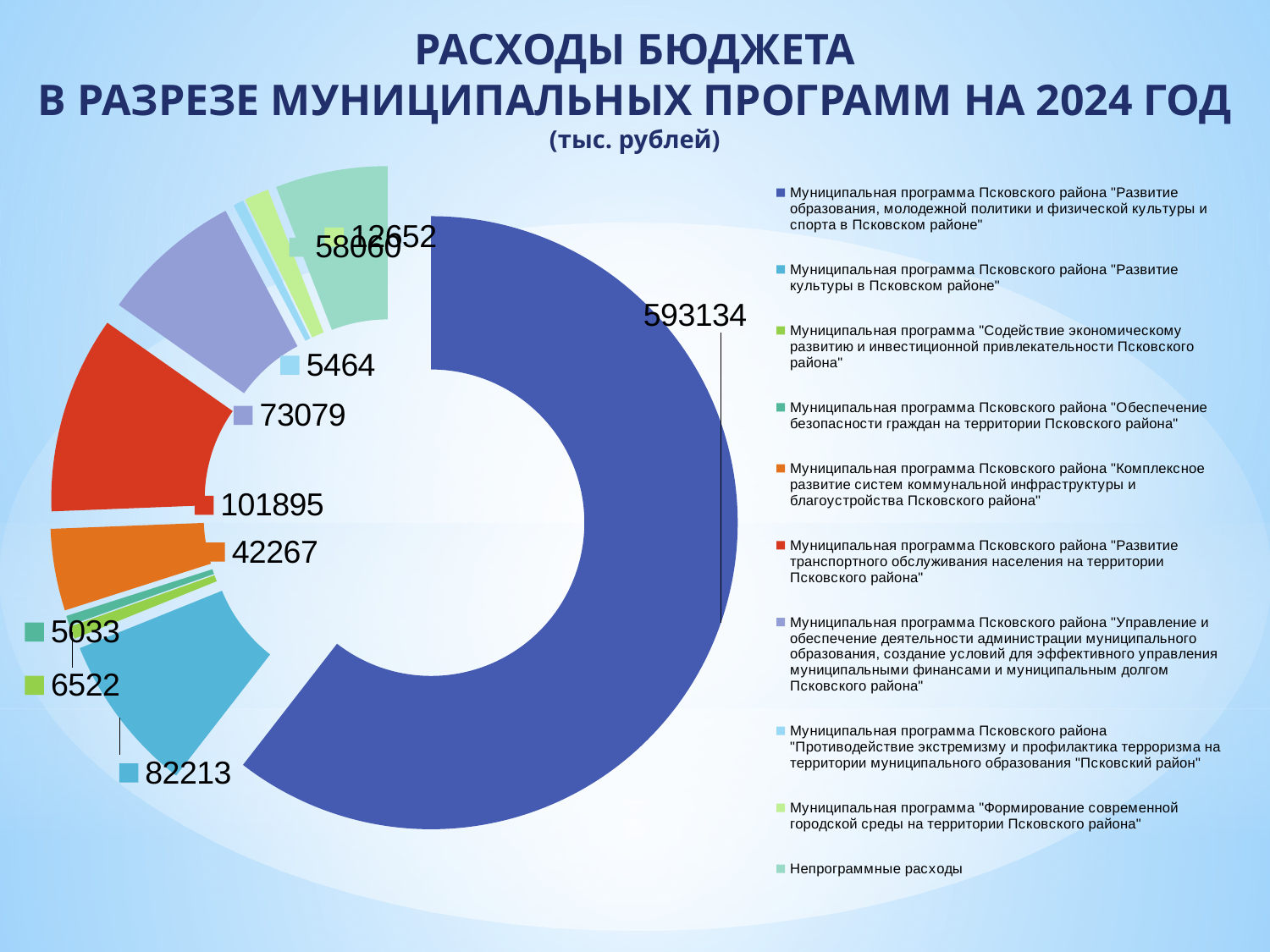
What is the difference between the transport services program (101895) and the culture program (82213)? 19682 Which is larger: the value for the transport services program or the value for the culture program? Transport services program (101895) How many entries does the legend list? 10 What kind of chart is shown on the slide? Doughnut (pie) chart What is the value for the municipal program "Управление и обеспечение деятельности администрации муниципального образования..."? 73079 What is the value for the municipal program "Развитие транспортного обслуживания населения на территории Псковского района"? 101895 What is the value for the municipal program "Развитие образования, молодежной политики и физической культуры и спорта в Псковском районе"? 593134 What is the value for the municipal program "Развитие культуры в Псковском районе"? 82213 What is the value for the municipal program "Противодействие экстремизму и профилактика терроризма..."? 5464 What is the value for the municipal program "Комплексное развитие систем коммунальной инфраструктуры и благоустройства Псковского района"? 42267 What is the value for the municipal program "Обеспечение безопасности граждан на территории Псковского района"? 5033 Which program has the largest share of budget expenditures? Развитие образования, молодежной политики и физической культуры и спорта в Псковском районе